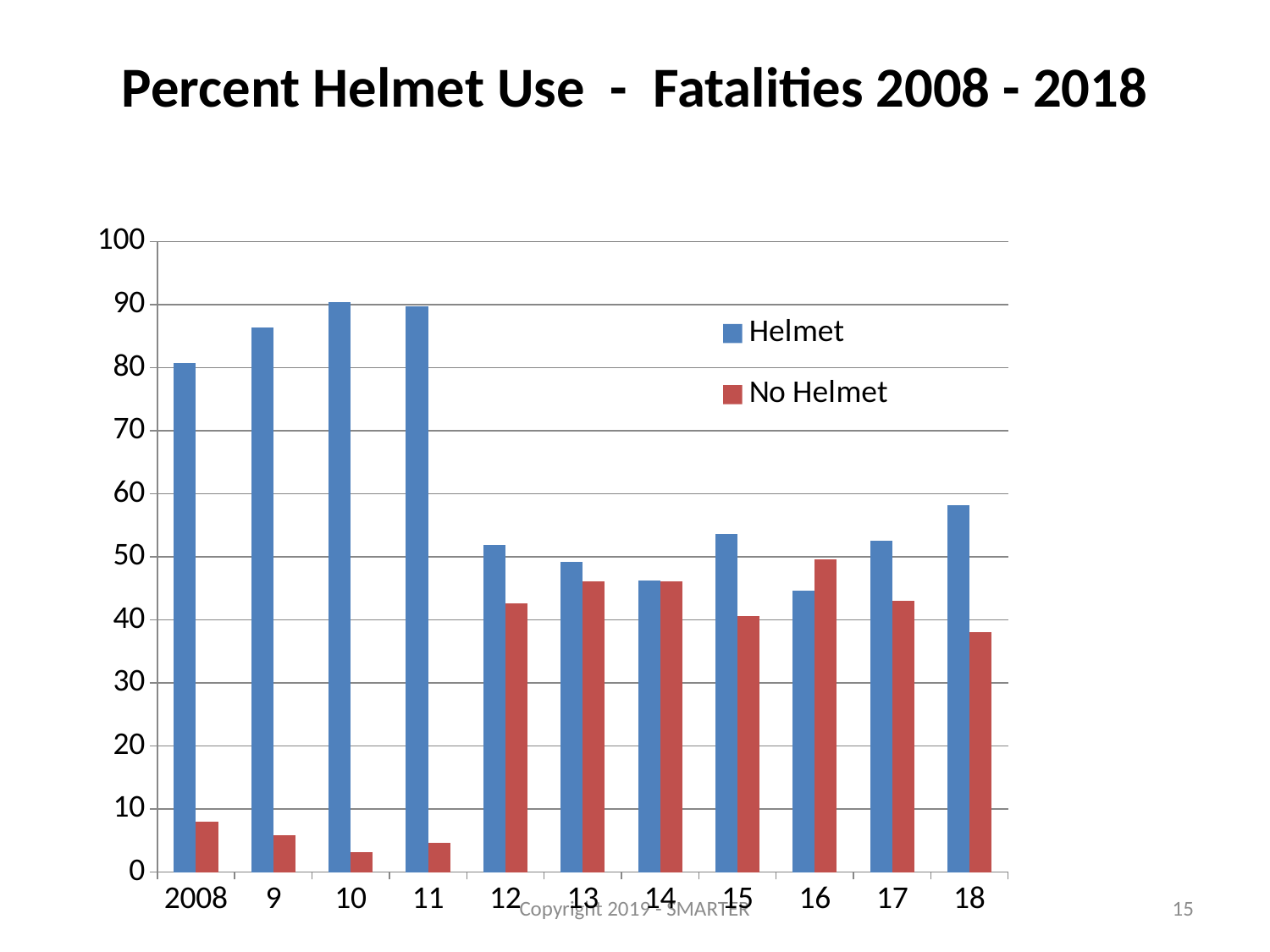
Is the Helmet value for 18 greater or less than 50? greater Is the Helmet value for 2008 greater or less than 70? greater Is the No Helmet value for 2008 greater or less than 10? less How many series does the legend list? 2 Which year has the lowest No Helmet value? 10 Which year has the highest No Helmet value? 16 What kind of chart is shown on the slide? bar chart For 16, which is larger: the Helmet value or the No Helmet value? No Helmet Overall, do the Helmet values rise or fall from 2008 to 18? fall How many year categories are shown on the x axis? 11